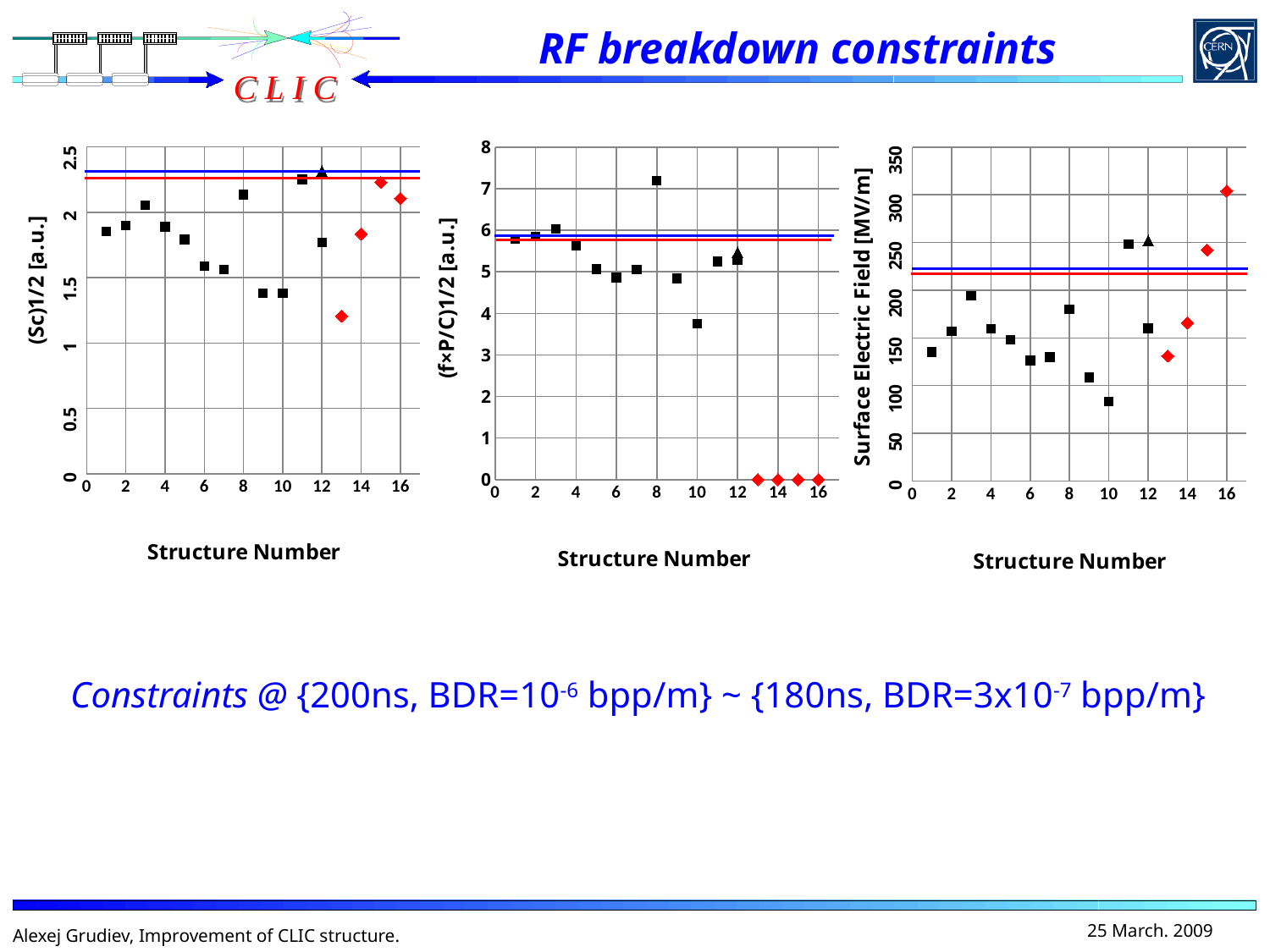
In the right chart (Surface Electric Field), which structure number has the lowest value? 10 What kind of chart is the left chart with y-axis (Sc)1/2 [a.u.]? scatter chart In the middle chart ((f×P/C)1/2), which structure number has the highest value? 8 In the middle chart ((f×P/C)1/2), is the value for structure number 10 greater or less than 4? less In the left chart ((Sc)1/2), is the value for structure number 13 greater or less than 1.5? less What is the x-axis label shared by all three charts? Structure Number In the right chart (Surface Electric Field), which is larger, the value for structure number 16 or structure number 10? structure number 16 In the left chart ((Sc)1/2), which structure number has the lowest value? 13 In the middle chart ((f×P/C)1/2), what is the value for structure number 14? 0 In the right chart (Surface Electric Field), is the value for structure number 9 greater or less than 150? less In the right chart (Surface Electric Field), which structure number has the highest value? 16